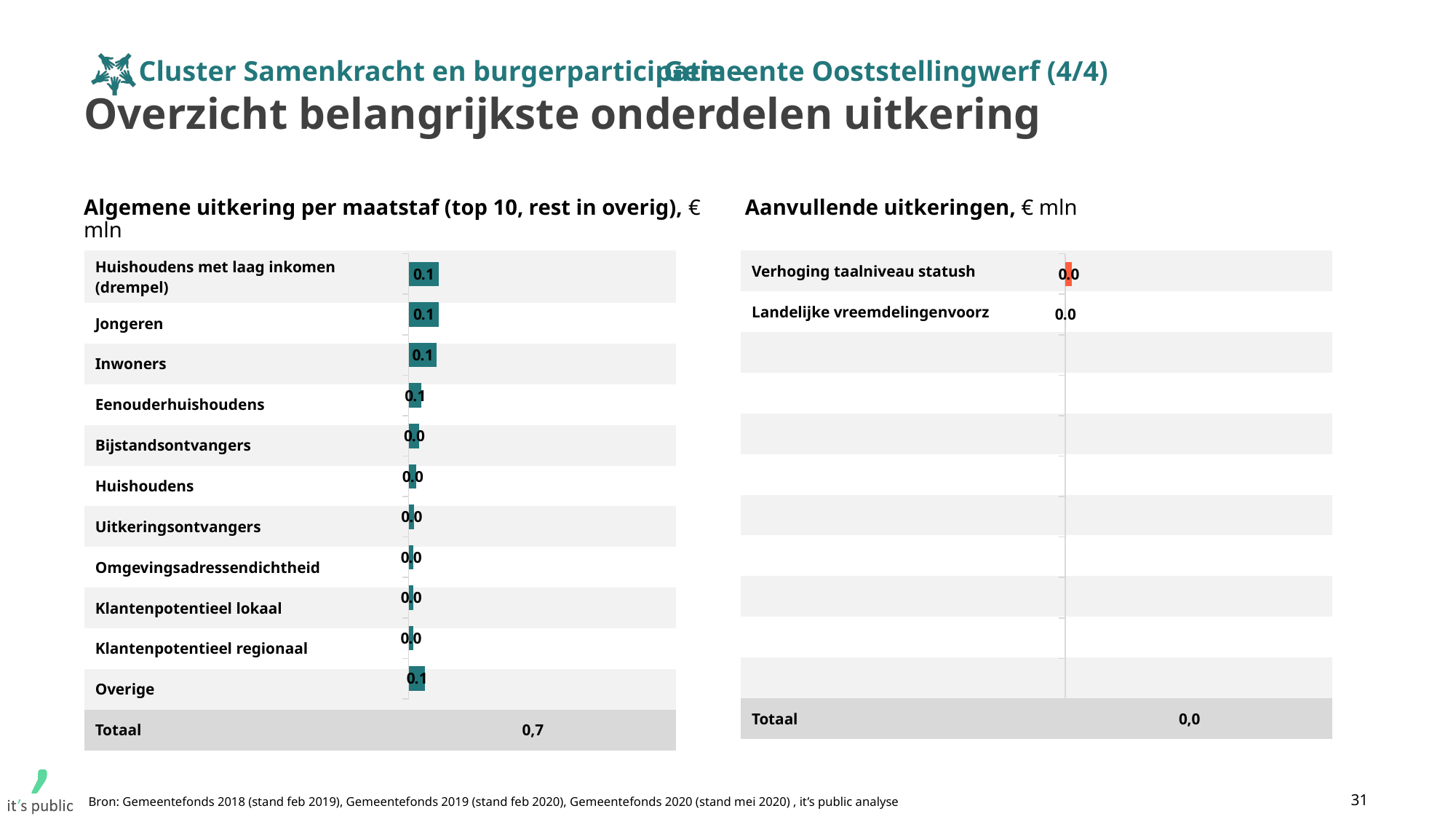
In the chart 'Algemene uitkering per maatstaf (top 10, rest in overig), € mln', what is the value for Bijstandsontvangers? 0.0 In the chart 'Algemene uitkering per maatstaf (top 10, rest in overig), € mln', what is the value for Overige? 0.1 In the chart 'Algemene uitkering per maatstaf (top 10, rest in overig), € mln', what is the value for Klantenpotentieel lokaal? 0.0 How many categories (excluding Totaal) are shown in the chart 'Algemene uitkering per maatstaf (top 10, rest in overig), € mln'? 11 In the chart 'Aanvullende uitkeringen, € mln', what is the value for Verhoging taalniveau statush? 0.0 In the chart 'Aanvullende uitkeringen, € mln', what is the Totaal shown? 0,0 What kind of chart is 'Algemene uitkering per maatstaf (top 10, rest in overig), € mln'? Bar chart How many categories (excluding Totaal) are shown in the chart 'Aanvullende uitkeringen, € mln'? 2 In the chart 'Algemene uitkering per maatstaf (top 10, rest in overig), € mln', what is the value for Jongeren? 0.1 In the chart 'Algemene uitkering per maatstaf (top 10, rest in overig), € mln', what is the Totaal shown? 0,7 In the chart 'Algemene uitkering per maatstaf (top 10, rest in overig), € mln', which is larger: Huishoudens met laag inkomen (drempel) or Klantenpotentieel regionaal? Huishoudens met laag inkomen (drempel) In the chart 'Aanvullende uitkeringen, € mln', what is the value for Landelijke vreemdelingenvoorz? 0.0